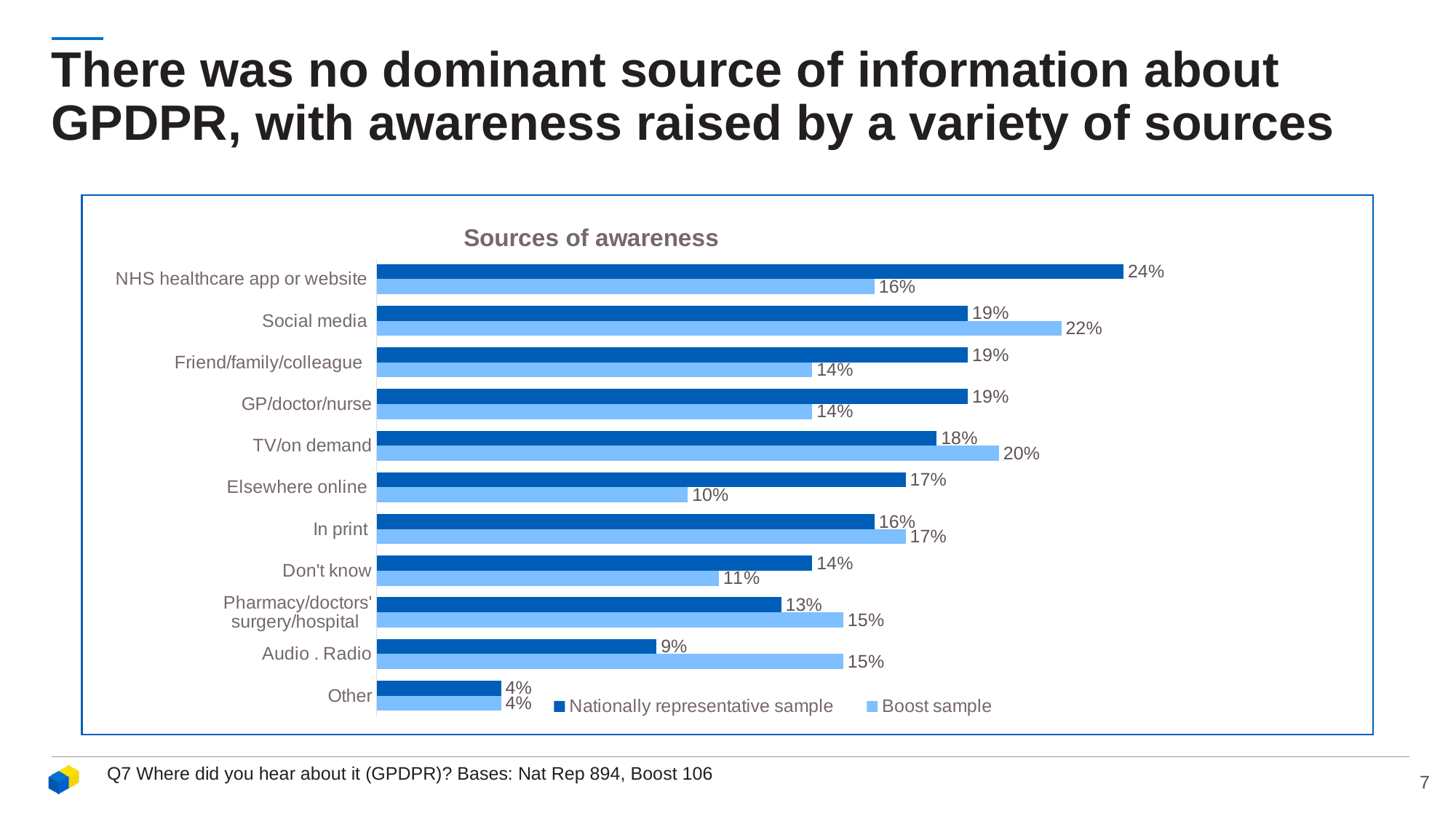
Which is larger for TV/on demand: the Nationally representative sample value or the Boost sample value? Boost sample What kind of chart is shown on the slide? Bar chart What is the value for Elsewhere online in the Boost sample series? 10% Which category has the highest value in the Nationally representative sample series? NHS healthcare app or website How many categories are shown on the chart? 11 What is the title of the chart? Sources of awareness What is the value for Social media in the Boost sample series? 22% What is the difference between the Nationally representative sample and Boost sample values for Audio . Radio? 6% Which category has the lowest value in the Boost sample series? Other What is the value for Pharmacy/doctors' surgery/hospital in the Nationally representative sample series? 13% What is the value for NHS healthcare app or website in the Nationally representative sample series? 24% How many series does the legend list? 2